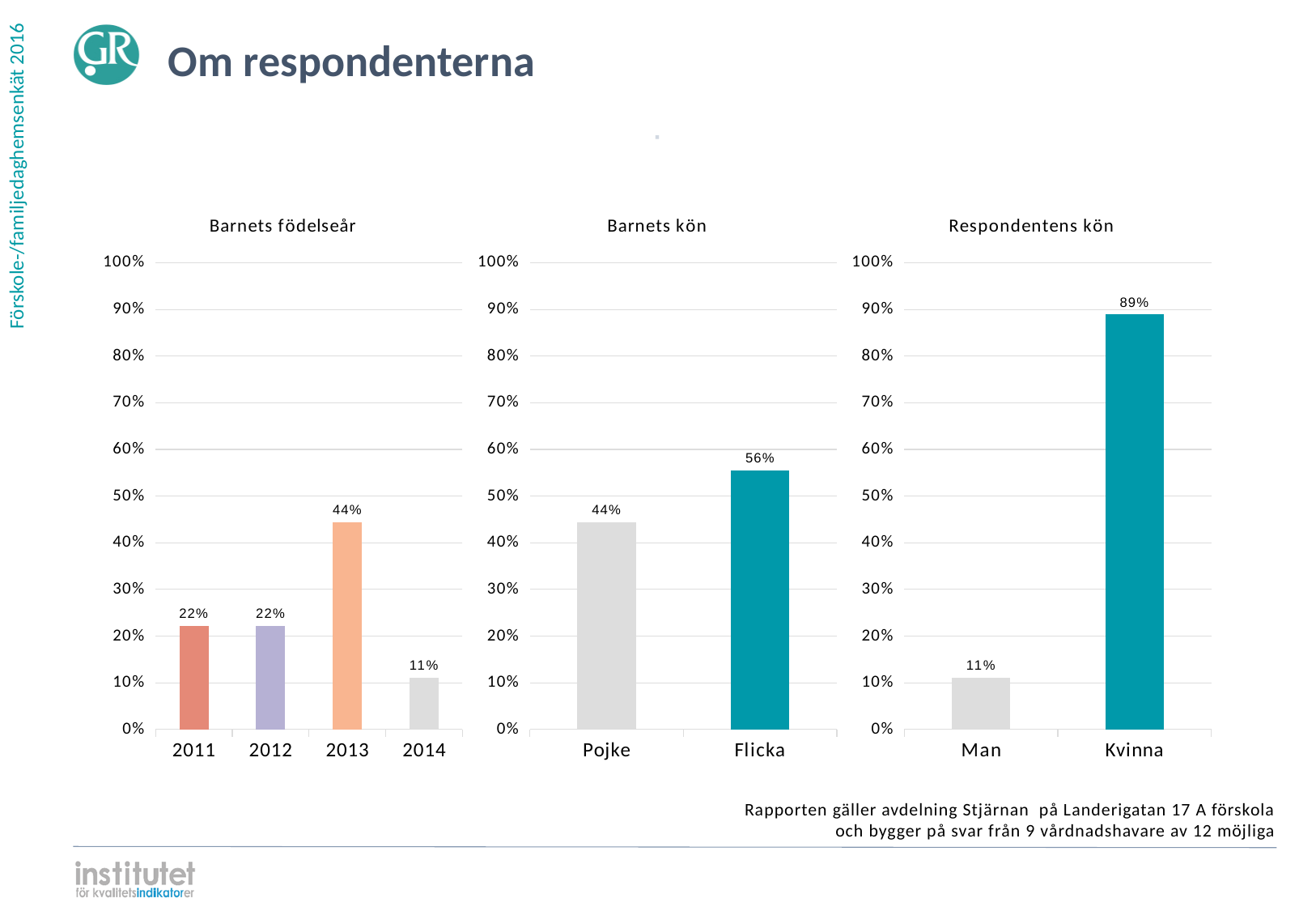
In the 'Barnets födelseår' chart, how many birth years are shown? 4 What kind of chart is the 'Respondentens kön' chart? Bar chart In the 'Respondentens kön' chart, what is the value for Man? 11% How many charts are shown on the slide? 3 In the 'Barnets födelseår' chart, what is the value for 2013? 44% In the 'Barnets födelseår' chart, which birth year has the lowest value? 2014 In the 'Barnets kön' chart, what is the difference between Flicka and Pojke? 12% In the 'Barnets kön' chart, which is larger, Pojke or Flicka? Flicka In the 'Barnets födelseår' chart, which birth year has the highest value? 2013 In the 'Barnets födelseår' chart, what is the difference between the values for 2013 and 2014? 33% In the 'Respondentens kön' chart, what is the difference between Kvinna and Man? 78% In the 'Barnets kön' chart, what is the value for Flicka? 56%